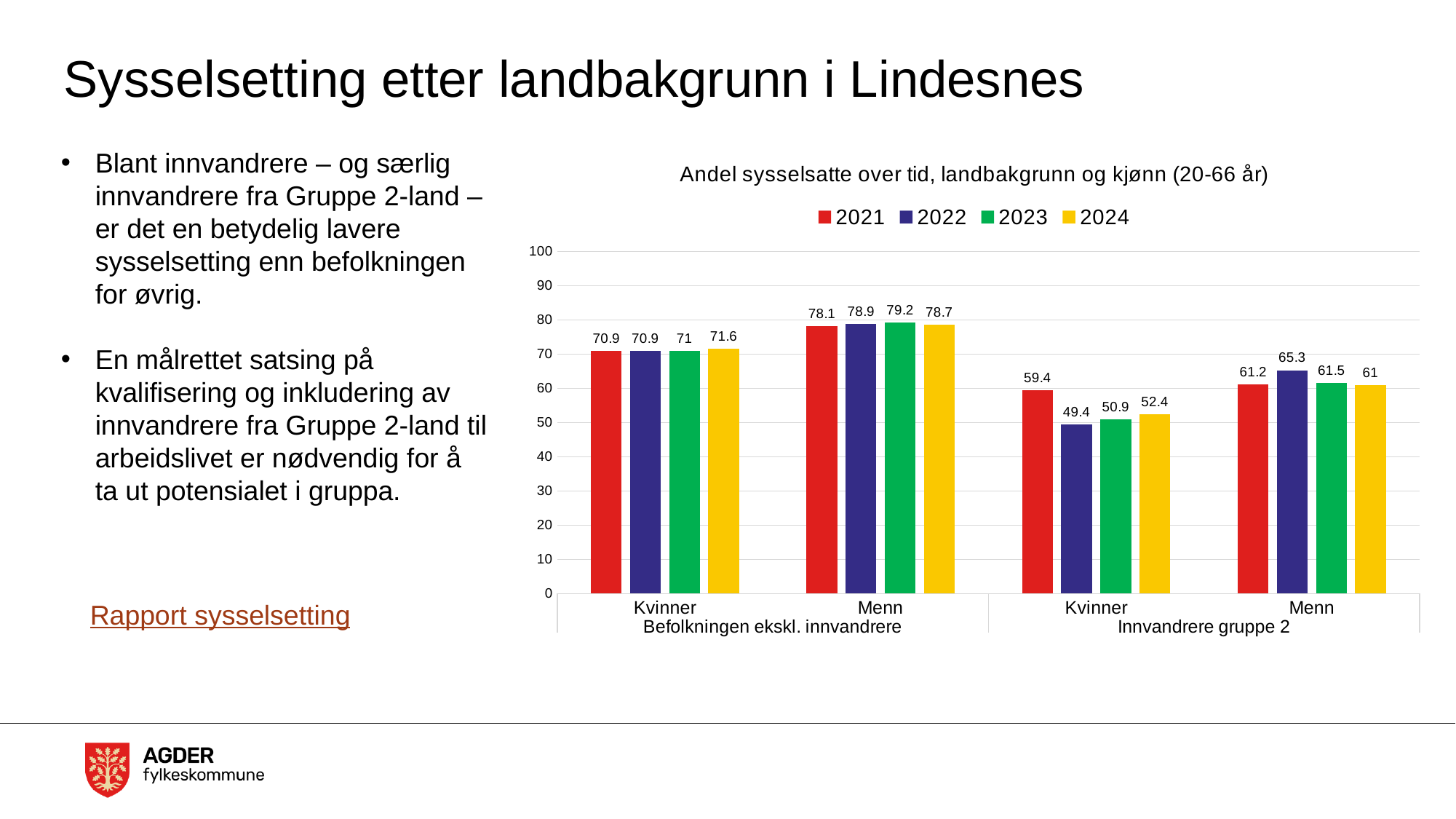
What is the title of the chart? Andel sysselsatte over tid, landbakgrunn og kjønn (20-66 år) What is the 2021 value for Kvinner in the group Innvandrere gruppe 2? 59.4 Which is larger: the 2024 value for Menn in Befolkningen ekskl. innvandrere or the 2024 value for Menn in Innvandrere gruppe 2? Menn in Befolkningen ekskl. innvandrere What is the 2024 value for Kvinner in the group Befolkningen ekskl. innvandrere? 71.6 Which year has the highest value for Menn in the group Innvandrere gruppe 2? 2022 What is the difference between the 2021 and 2022 values for Kvinner in the group Innvandrere gruppe 2? 10 What is the 2023 value for Menn in the group Befolkningen ekskl. innvandrere? 79.2 What is the 2022 value for Menn in the group Innvandrere gruppe 2? 65.3 What type of chart is shown on the slide? bar chart How many series does the legend list? 4 Do the values for Kvinner in the group Innvandrere gruppe 2 rise or fall from 2022 to 2024? rise Which year has the lowest value for Kvinner in the group Innvandrere gruppe 2? 2022